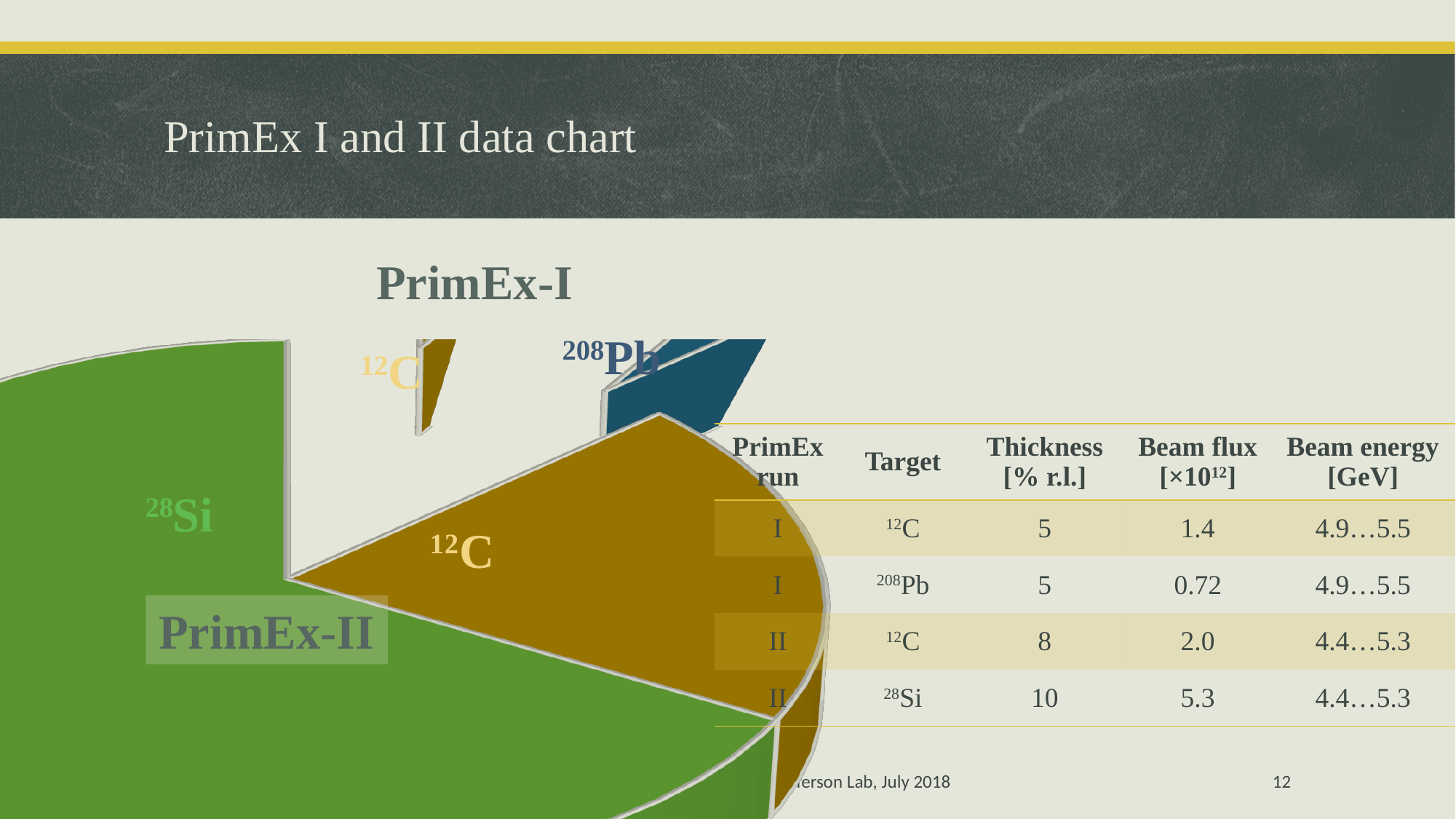
How many pie charts are shown on the slide? 1 In the PrimEx-II chart, what colour is the 28Si slice? green What kind of chart is the PrimEx-I chart? pie chart How many labelled slices does the PrimEx-II chart have? 2 What kind of chart is the PrimEx-II chart? pie chart In the PrimEx-II chart, which slice is larger, 28Si or 12C? 28Si In the PrimEx-I chart, what colour is the 208Pb slice? blue How many labelled slices does the PrimEx-I chart have? 2 In the PrimEx-II chart, which slice is the smallest? 12C In the PrimEx-II chart, which slice is the largest? 28Si